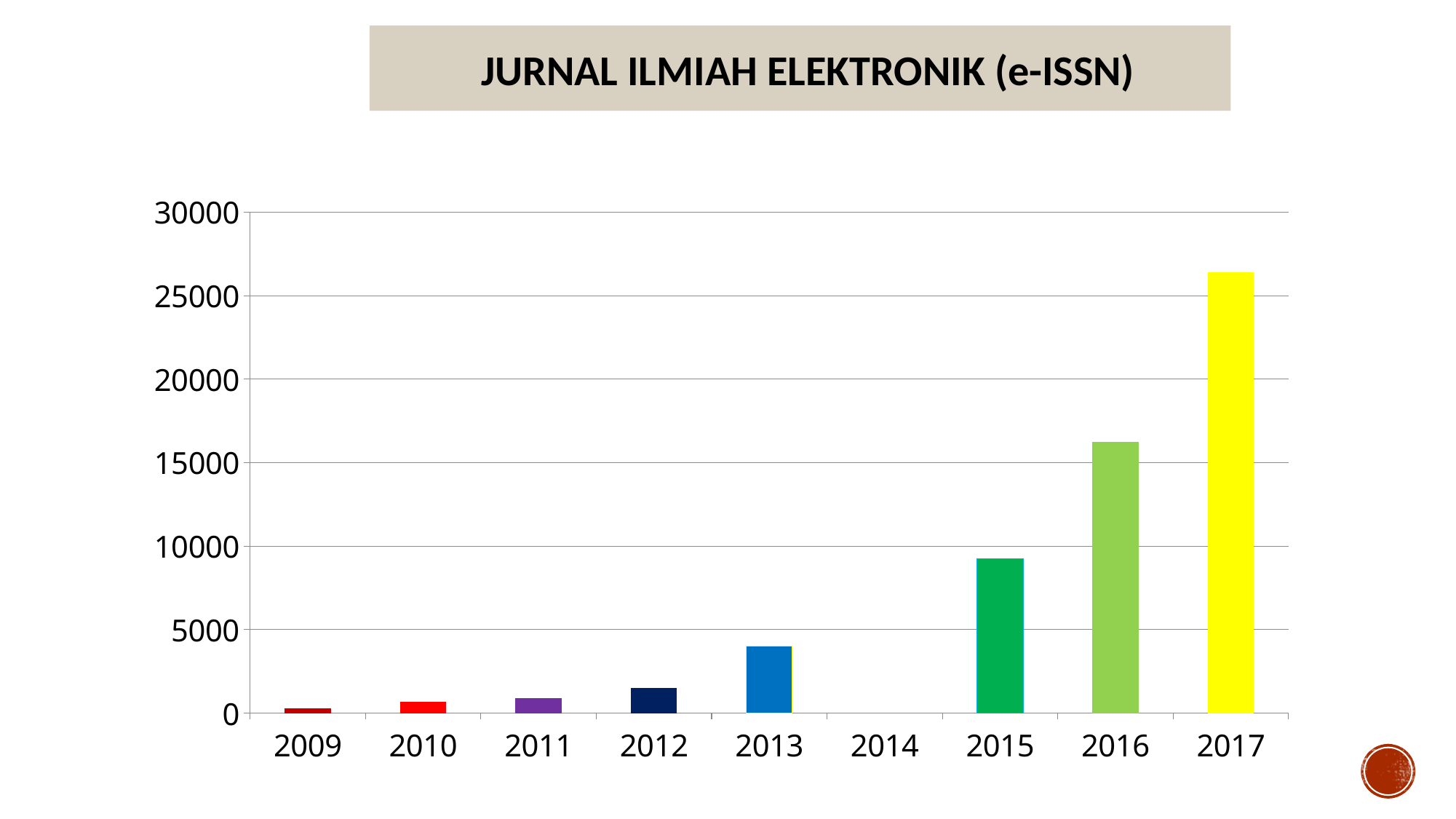
Is the value for 2016 greater or less than 15000? greater Is the value for 2015 greater or less than 10000? less Which year has the highest value in the chart? 2017 Is the value for 2017 greater or less than 25000? greater What kind of chart is shown on the slide? bar chart Do the values generally rise or fall from 2009 to 2017? rise How many years are shown on the x axis of the chart? 9 What is the title of the chart? JURNAL ILMIAH ELEKTRONIK (e-ISSN) Which is larger, the value for 2013 or the value for 2012? 2013 Which is larger, the value for 2016 or the value for 2015? 2016 Which year on the x axis has no visible bar? 2014